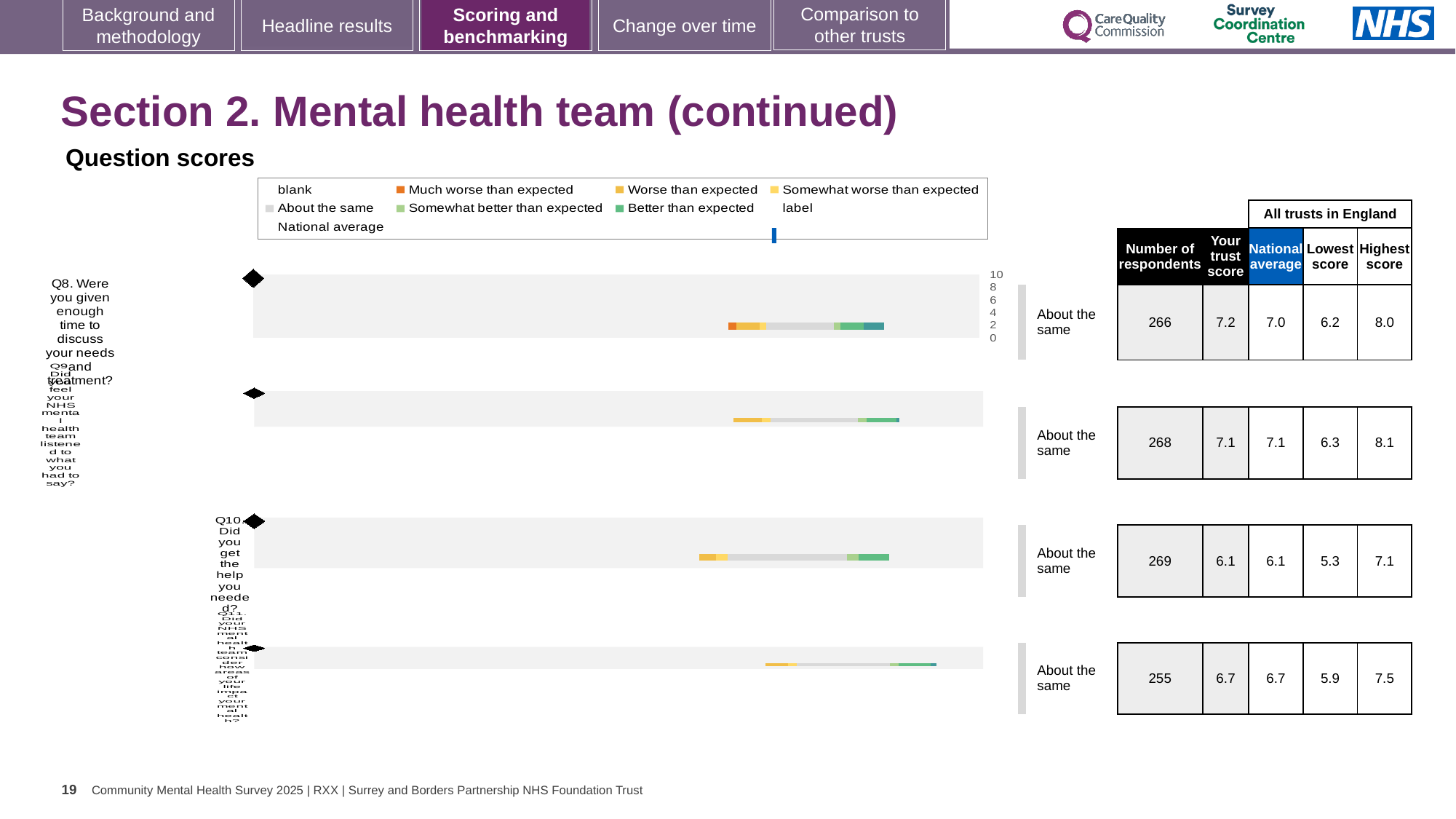
In the table next to the Q11 chart, what is the highest score among all trusts in England? 7.5 In the table next to the Q8 chart, what is the 'Your trust score' value? 7.2 In the table next to the Q10 chart, what is the lowest score among all trusts in England? 5.3 What is the difference between the highest score and the lowest score for Q9 in the table? 1.8 What colour is the 'Much worse than expected' legend entry? orange What kind of chart is used to show the question scores on this slide? bar chart How many question charts (Q8 to Q11) are shown on the slide? 4 Which question chart has the most respondents according to the tables? Q10 In the table next to the Q8 chart, what is the number of respondents? 266 Is the trust score for Q8 larger or smaller than the national average for Q8? larger What benchmark label is shown beside the Q10 chart? About the same Which question chart has the fewest respondents according to the tables? Q11